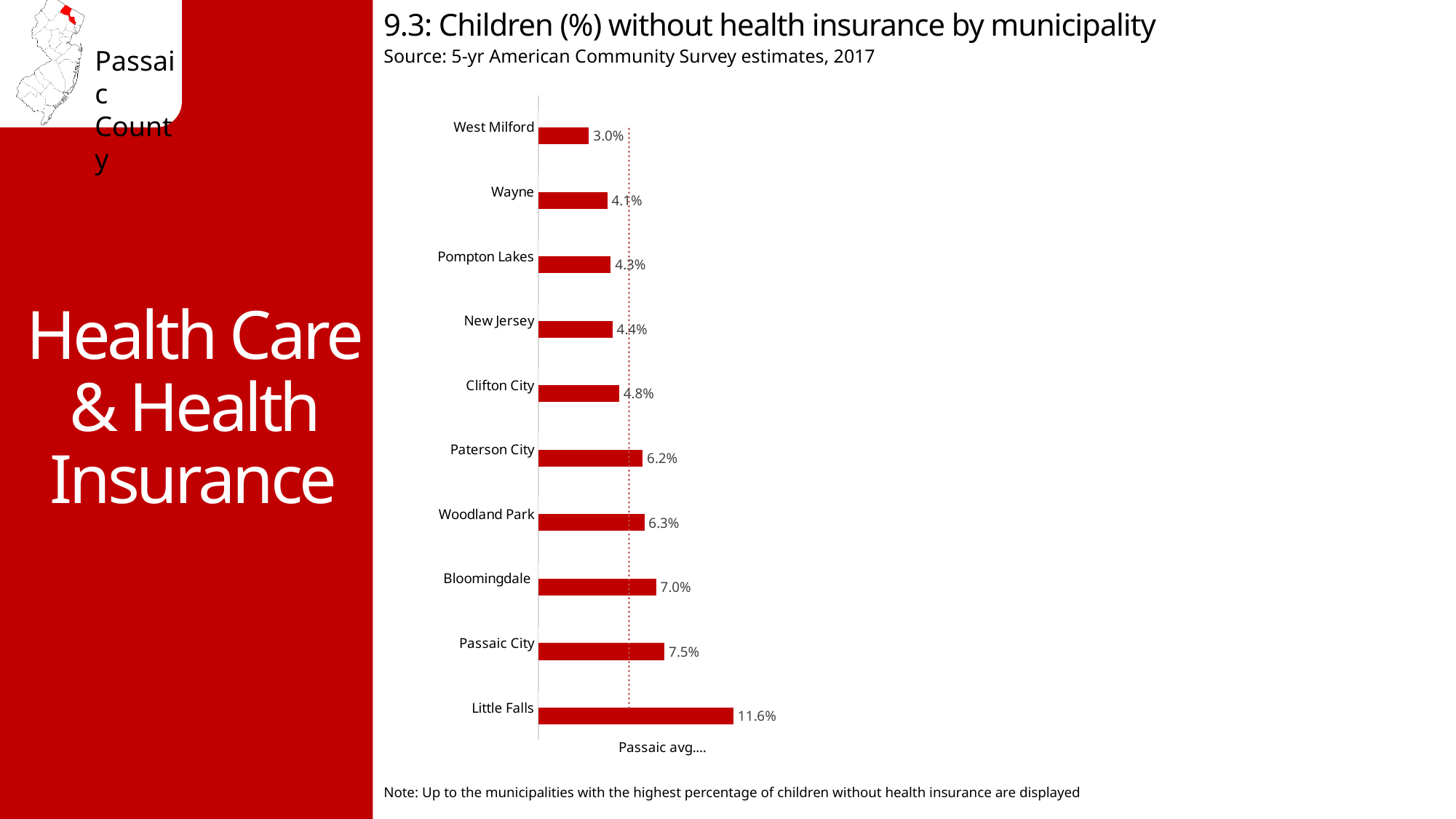
What is the difference between the values for Little Falls and Passaic City? 4.1% What does the dotted vertical line in the chart represent? Passaic avg. What is the difference between the values for Bloomingdale and West Milford? 4.0% What is the value shown for New Jersey? 4.4% What percentage of children in Little Falls are without health insurance? 11.6% What type of chart is used to show children without health insurance by municipality? Bar chart Which municipality has the lowest percentage of children without health insurance? West Milford What is the value shown for Wayne? 4.1% Which has a higher percentage of children without health insurance, Paterson City or Pompton Lakes? Paterson City Which municipality has the highest percentage of children without health insurance? Little Falls How many municipalities or areas are shown in the chart? 10 What percentage is shown for Clifton City? 4.8%